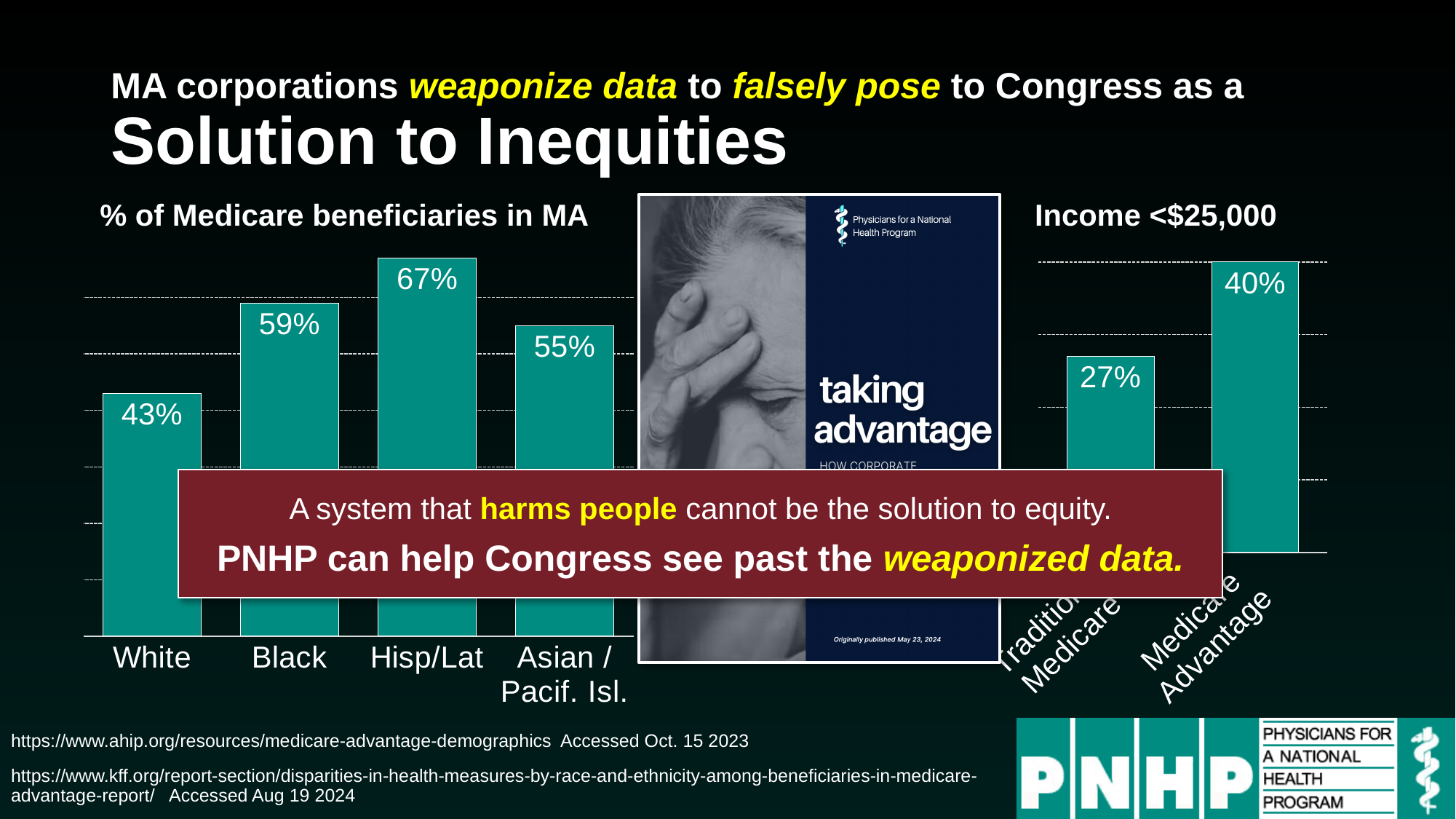
In the 'Income <$25,000' chart, what is the difference between Medicare Advantage and Traditional Medicare? 13% In the 'Income <$25,000' chart, what is the value for Medicare Advantage? 40% In the '% of Medicare beneficiaries in MA' chart, what is the difference between the values for Black and White? 16% In the '% of Medicare beneficiaries in MA' chart, which category has the highest value? Hisp/Lat What kind of chart is the '% of Medicare beneficiaries in MA' chart? Bar chart How many categories are shown in the '% of Medicare beneficiaries in MA' chart? 4 In the '% of Medicare beneficiaries in MA' chart, what is the value for White? 43% In the '% of Medicare beneficiaries in MA' chart, which is larger, the value for Black or the value for Asian / Pacif. Isl.? Black In the '% of Medicare beneficiaries in MA' chart, what is the value for Hisp/Lat? 67% In the 'Income <$25,000' chart, what is the value for Traditional Medicare? 27% In the '% of Medicare beneficiaries in MA' chart, which category has the lowest value? White How many bars are shown in the 'Income <$25,000' chart? 2